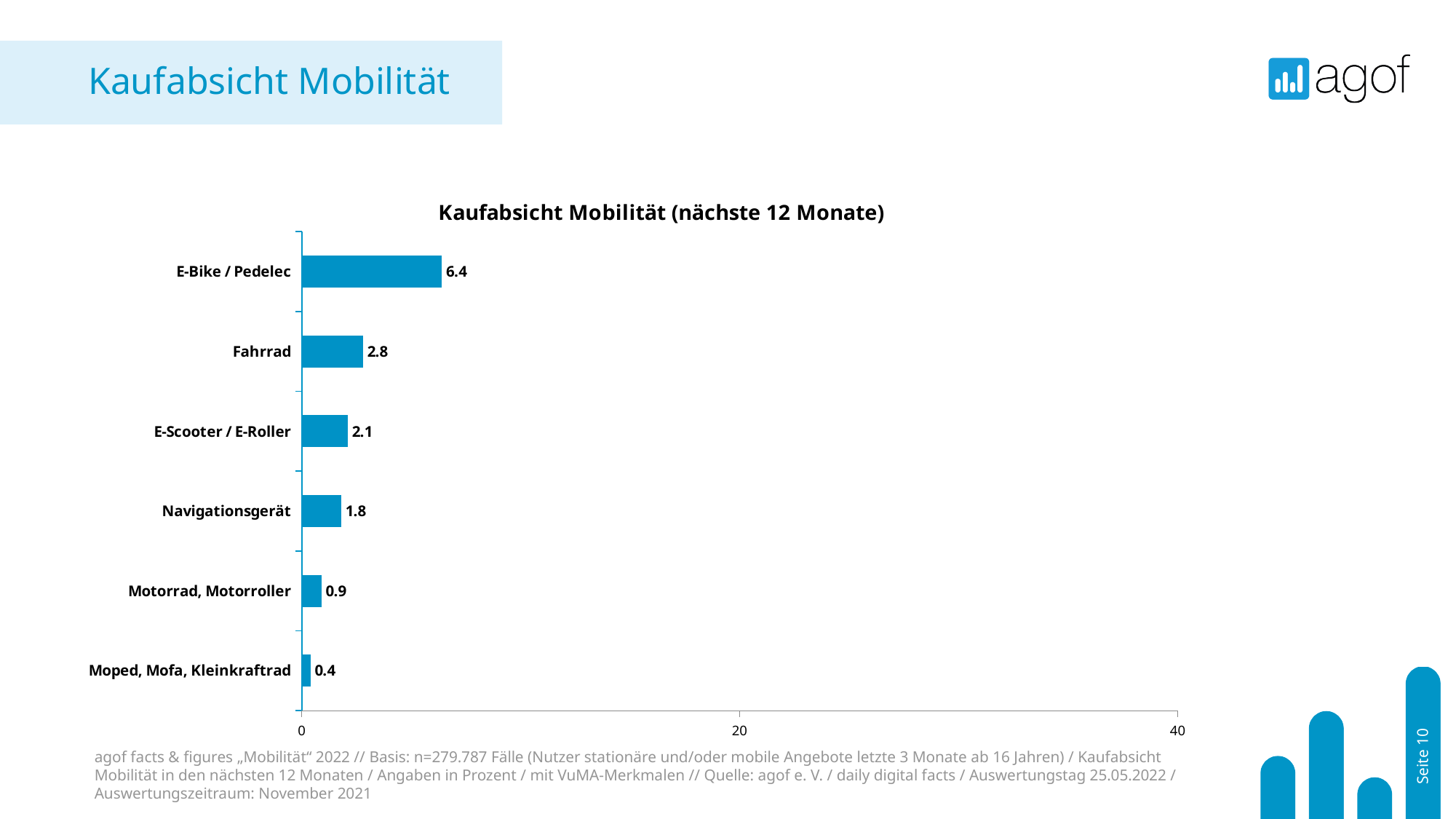
What is the title of the chart? Kaufabsicht Mobilität (nächste 12 Monate) Which is larger, the value for E-Scooter / E-Roller or the value for Motorrad, Motorroller? E-Scooter / E-Roller Which category has the lowest value? Moped, Mofa, Kleinkraftrad What kind of chart is shown on the slide? bar chart What is the value for Navigationsgerät? 1.8 What is the value for Fahrrad? 2.8 What is the value for E-Bike / Pedelec? 6.4 Which category has the highest value? E-Bike / Pedelec What is the difference between the values for E-Bike / Pedelec and Fahrrad? 3.6 How many categories are shown in the chart? 6 What is the value for Moped, Mofa, Kleinkraftrad? 0.4 Is the value for E-Bike / Pedelec greater or less than 20? less